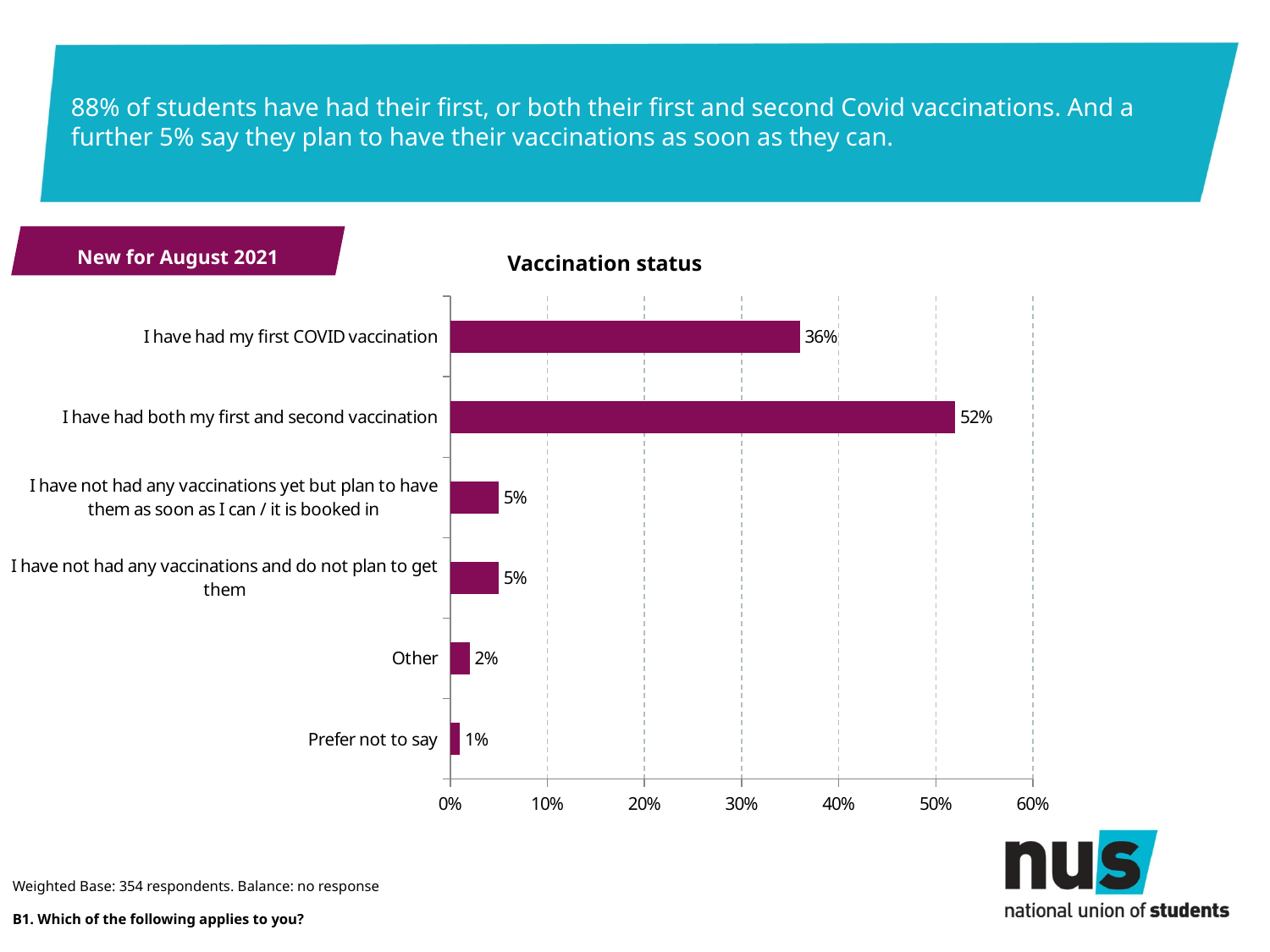
What is the title of the chart? Vaccination status What is the value for 'Other'? 2% How many categories are shown in the chart? 6 What type of chart is shown on the slide? Bar chart Which category has the lowest value? Prefer not to say What is the difference between the share who have had both vaccinations and the share who have had only their first? 16% Which category has the highest value? I have had both my first and second vaccination Is the value for 'I have had both my first and second vaccination' greater or less than 50%? greater What is the value for 'Prefer not to say'? 1% What percentage of students have had both their first and second vaccination? 52% Which is larger: the value for 'Other' or the value for 'Prefer not to say'? Other What percentage of students have had their first COVID vaccination? 36%